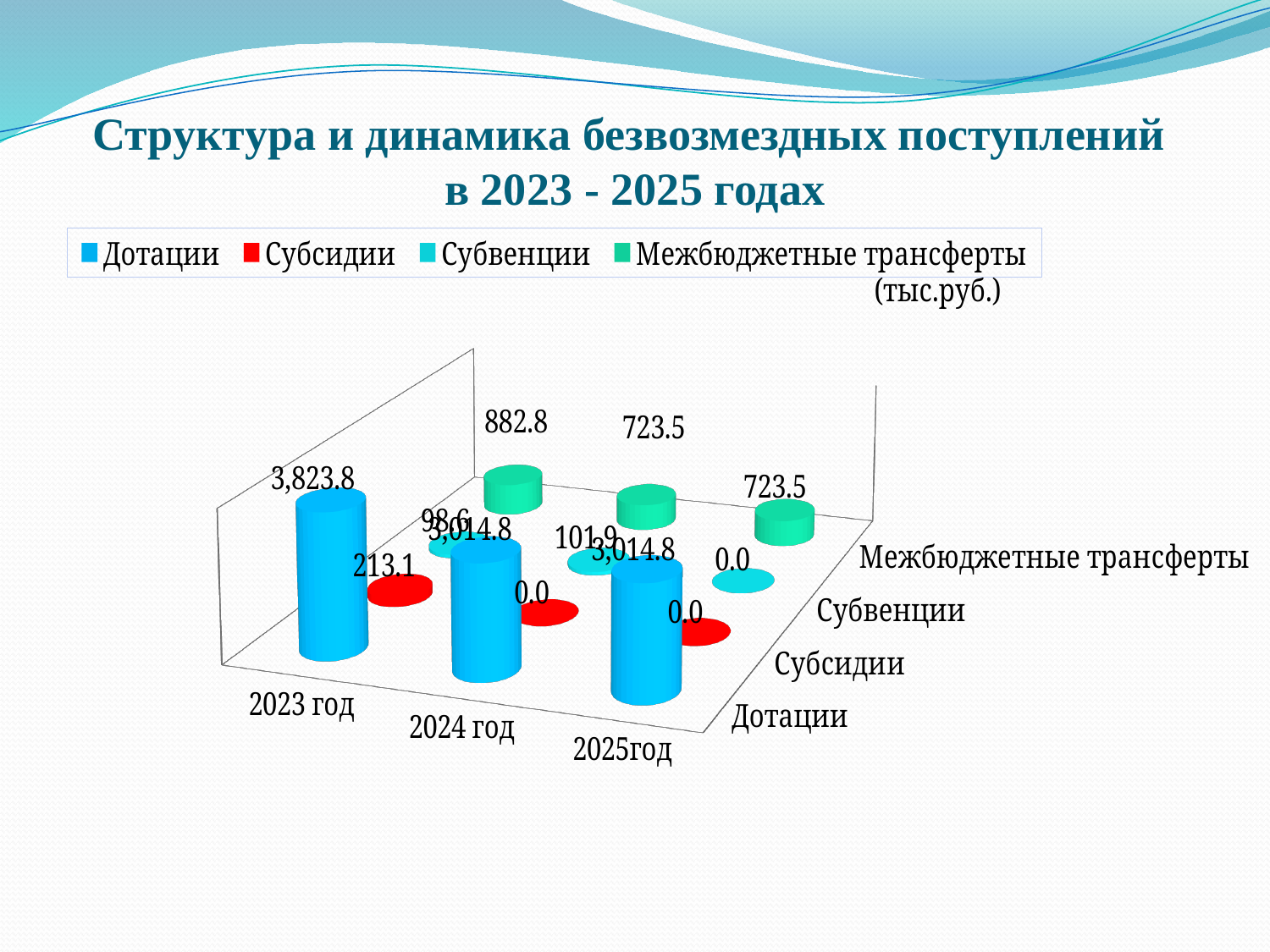
What is the value for Субсидии in 2023 год? 213.1 How many series does the legend list? 4 What is the difference between the Дотации values for 2023 год and 2024 год? 809.0 What is the value for Дотации in 2023 год? 3,823.8 How many years are shown along the x axis? 3 What is the value for Субвенции in 2024 год? 101.9 What is the value for Межбюджетные трансферты in 2023 год? 882.8 What type of chart is shown on the slide? bar chart Which year has the highest value for Дотации? 2023 год What is the value for Межбюджетные трансферты in 2024 год? 723.5 What is the value for Дотации in 2025год? 3,014.8 Do the values for Межбюджетные трансферты rise or fall from 2023 год to 2024 год? fall